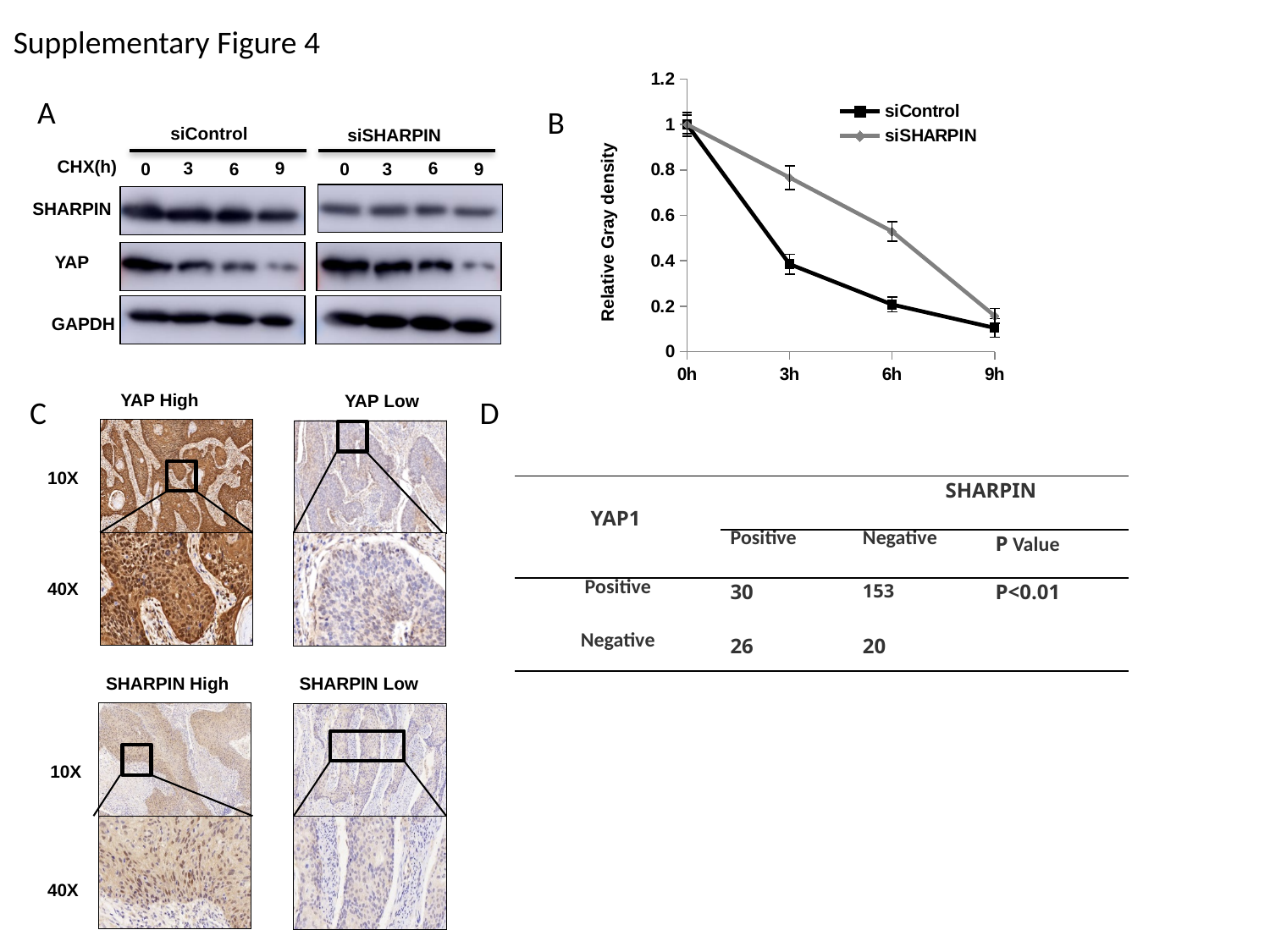
In panel B, at which time point is the siControl value lowest? 9h In panel B, at 3h, which series has the larger value, siControl or siSHARPIN? siSHARPIN In panel B, how many time points are plotted along the x axis? 4 In panel B, what kind of chart is shown? line chart In panel B, how many series does the legend list? 2 In panel B, which series is drawn in black with square markers? siControl In panel B, is the siControl value at 6h greater or less than 0.4? less In panel B, do the siControl values rise or fall from 0h to 9h? fall In panel B, what is the label of the y axis? Relative Gray density In panel B, at 6h, which series has the larger value, siControl or siSHARPIN? siSHARPIN In panel B, is the siSHARPIN value at 3h greater or less than 0.6? greater In panel B, is the siSHARPIN value at 6h greater or less than 0.4? greater